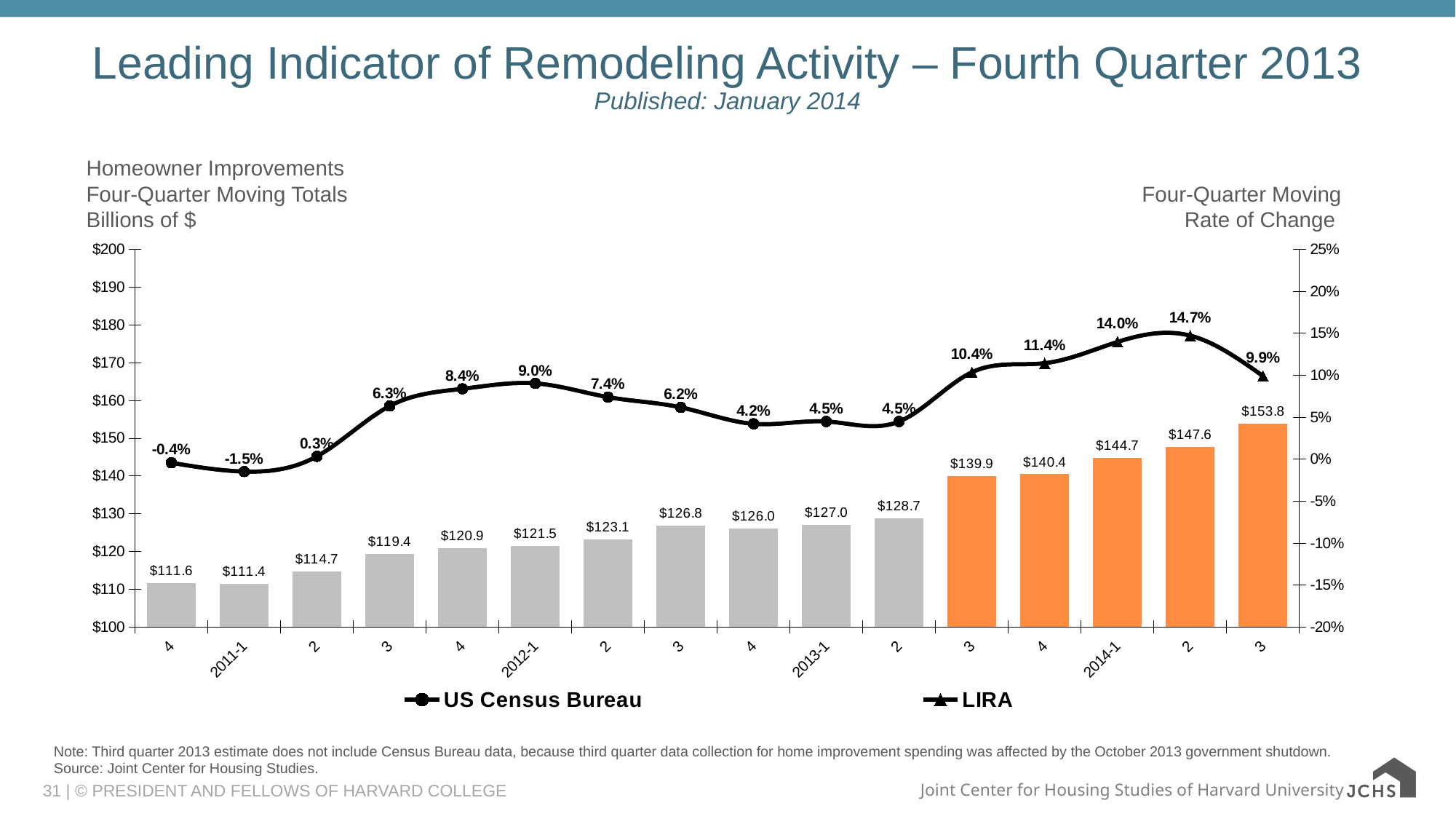
What is the value of the bar for quarter 2 of 2013? $128.7 What is the highest four-quarter moving rate of change shown on the line? 14.7% How many bars are plotted in the chart? 16 Which is larger, the bar for quarter 2 of 2012 or the bar for quarter 3 of 2012? Quarter 3 of 2012 ($126.8) Do the bar values generally rise or fall from left to right? Rise What is the four-quarter moving rate of change shown for 2012-1? 9.0% What is the value of the highest bar in the chart? $153.8 What kind of chart is shown on the slide? Combination bar and line chart What is the difference between the last bar ($153.8) and the bar before it ($147.6)? $6.2 What is the lowest four-quarter moving rate of change shown on the line? -1.5% How many series does the legend list? 2 What is the four-quarter moving total for 2014-1? $144.7